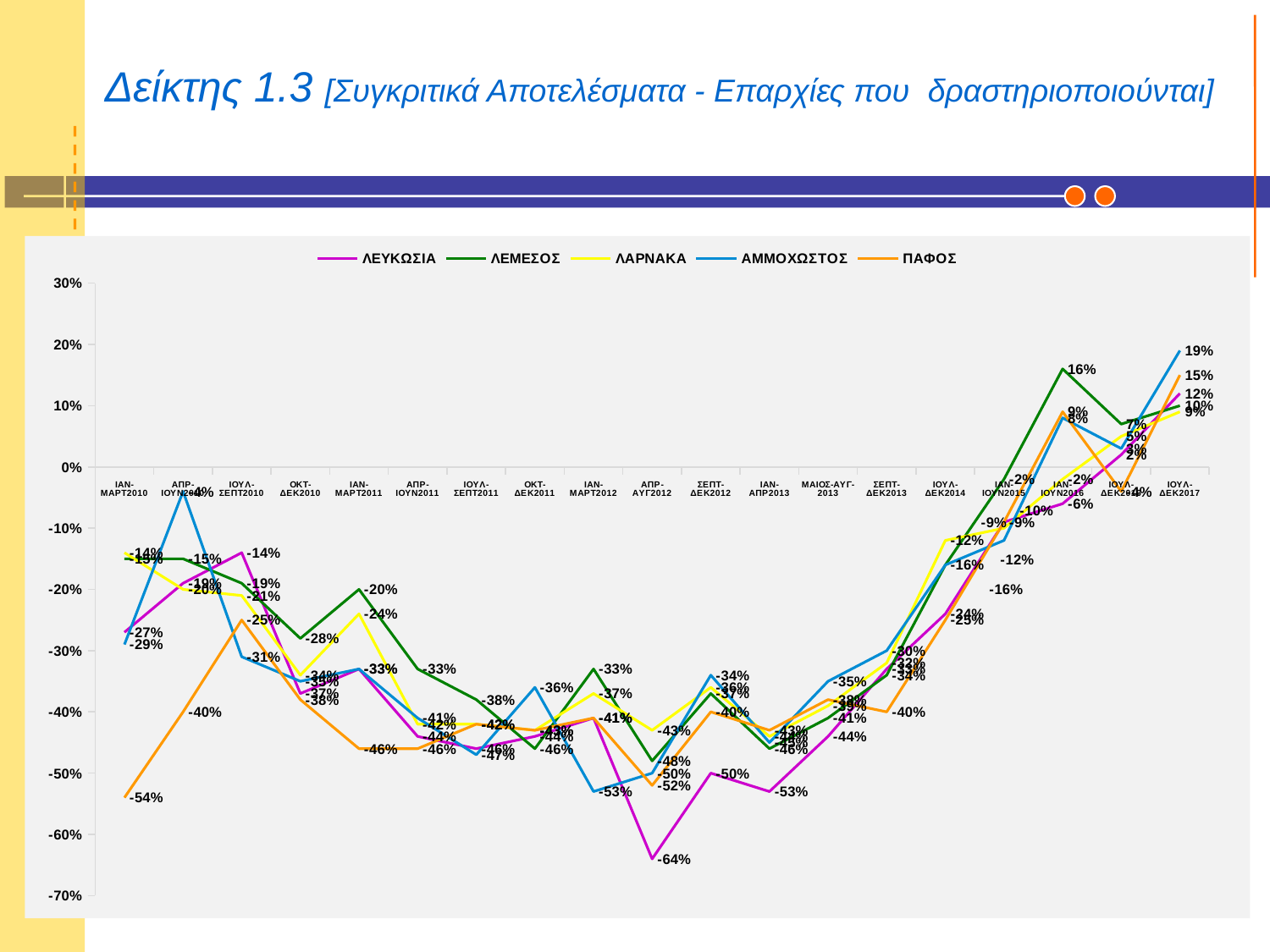
Overall, does the ΠΑΦΟΣ line rise or fall from ΙΑΝ-ΜΑΡΤ2010 to ΙΟΥΛ-ΔΕΚ2017? Rise Which series has the highest value in ΙΟΥΛ-ΔΕΚ2017? ΑΜΜΟΧΩΣΤΟΣ How many time periods are shown along the x axis? 19 What is the difference between ΑΜΜΟΧΩΣΤΟΣ and ΠΑΦΟΣ in ΙΟΥΛ-ΔΕΚ2017? 4 percentage points What kind of chart is shown on the slide? Line chart What is the value for ΛΕΜΕΣΟΣ in ΙΑΝ-ΙΟΥΝ2016? 16% What is the value for ΑΜΜΟΧΩΣΤΟΣ in ΙΟΥΛ-ΔΕΚ2017? 19% Which is larger in ΙΑΝ-ΜΑΡΤ2010: the value for ΛΕΥΚΩΣΙΑ or the value for ΠΑΦΟΣ? ΛΕΥΚΩΣΙΑ What is the value for ΠΑΦΟΣ in ΙΑΝ-ΜΑΡΤ2010? -54% What is the lowest value plotted anywhere on the chart? -64% How many series does the legend list? 5 What is the value for ΛΕΥΚΩΣΙΑ in ΑΠΡ-ΑΥΓ2012? -64%